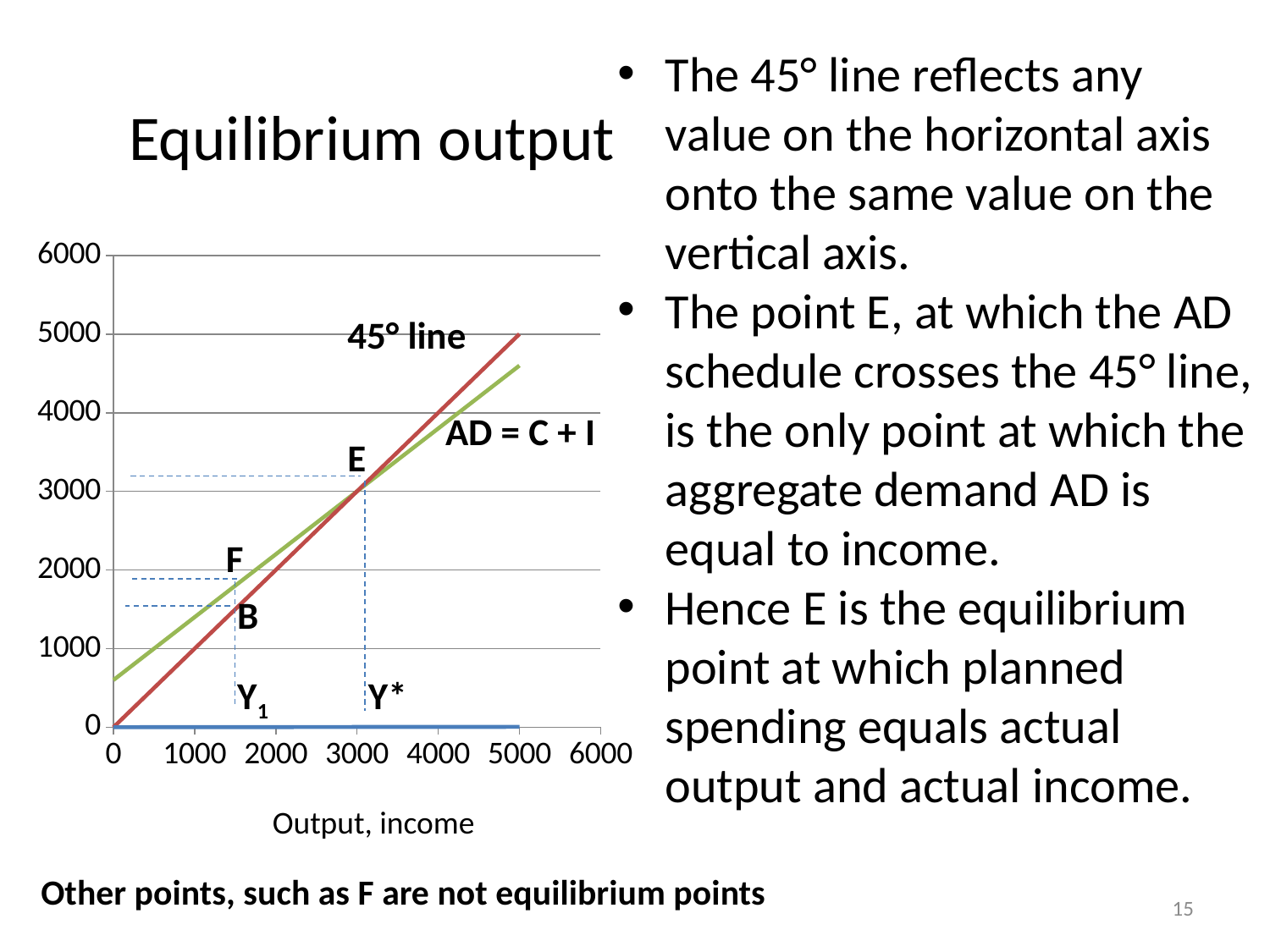
What label is given to the red line in the chart? 45° line What is the value of the 45° line at an output of 5000? 5000 What is the highest value shown on the vertical axis of the chart? 6000 Which point is labelled where the AD = C + I line crosses the 45° line? E At an output of 5000, which line is higher: the 45° line or the AD = C + I line? 45° line What kind of chart is shown on the slide? line chart Does the AD = C + I line rise or fall as output increases along the x axis? rise Is the value of the AD = C + I line at an output of 0 greater or less than 1000? less Is the vertical value at point E greater or less than 2000? greater Is the vertical value at point F greater or less than 1000? greater At an output of 0, which line is higher: the 45° line or the AD = C + I line? AD = C + I